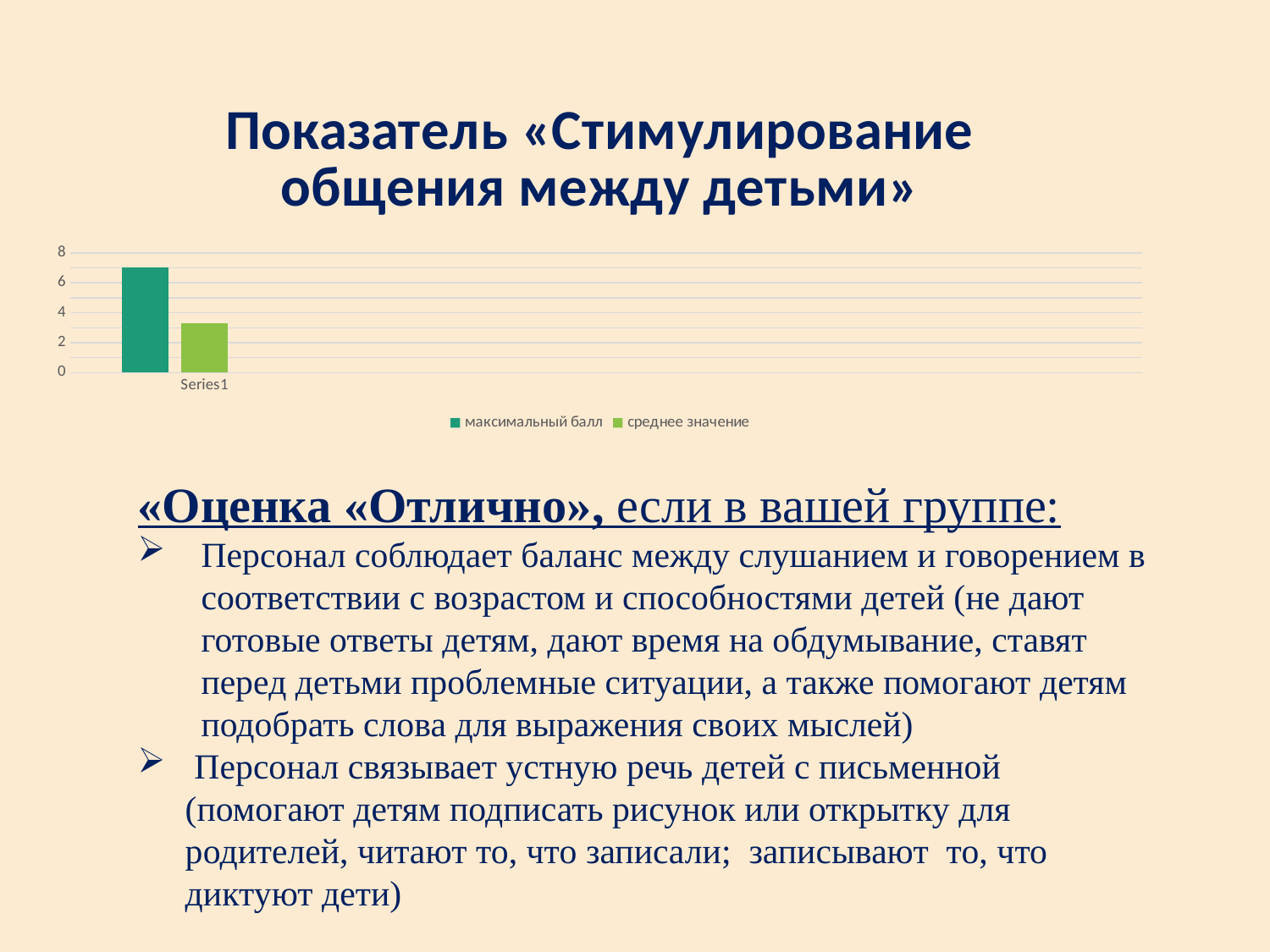
Is the value for среднее значение greater or less than 4? less How many categories are shown on the x axis of the chart? 1 How many series does the chart legend list? 2 Is the value for среднее значение greater or less than 2? greater What is the highest value shown on the chart's vertical axis? 8 Which series has the lowest bar in the chart? среднее значение What kind of chart is shown on the slide? bar chart Is the value for максимальный балл greater or less than 6? greater Which series has the taller bar, максимальный балл or среднее значение? максимальный балл What is the label of the category on the x axis? Series1